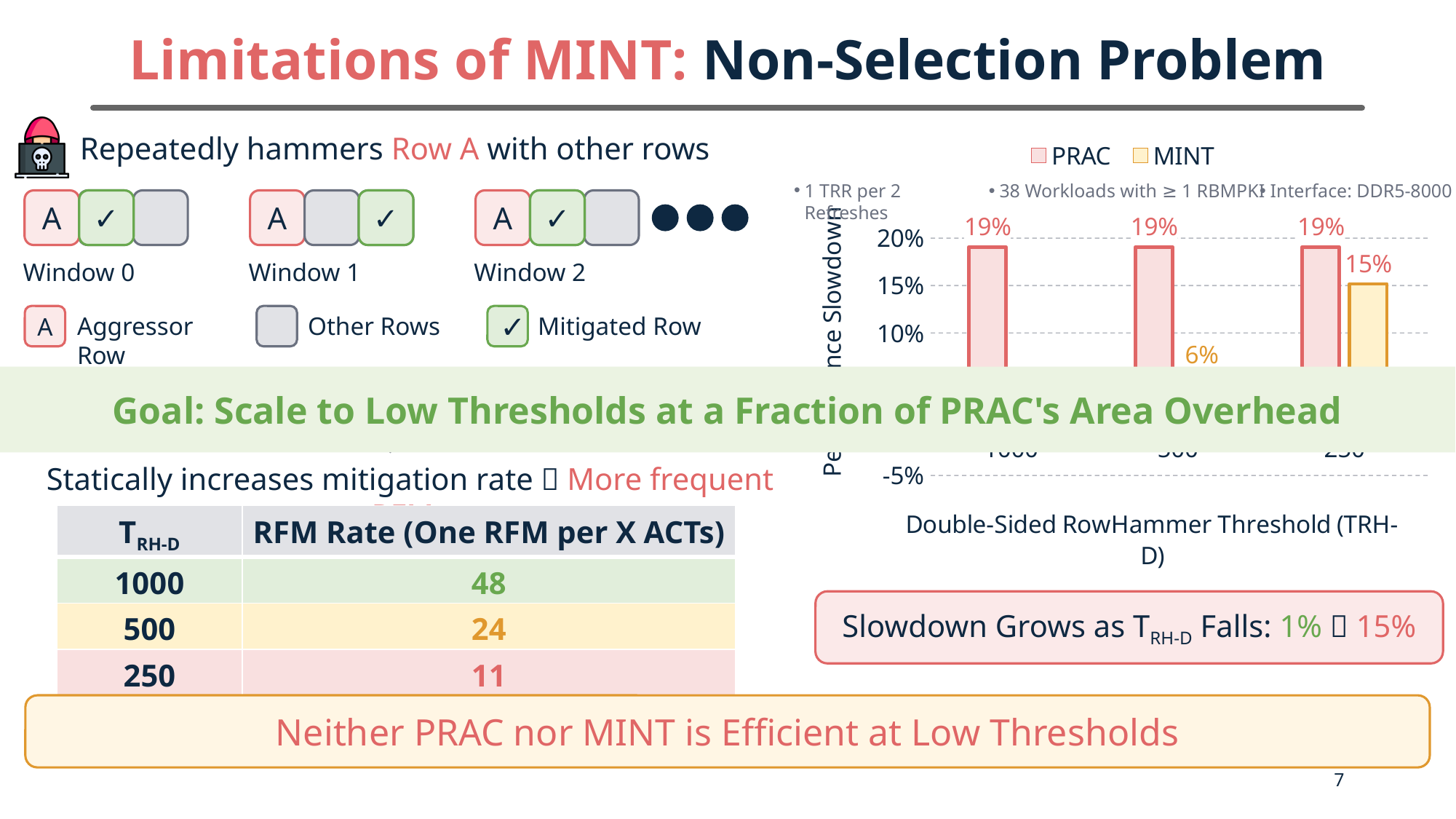
How many series does the chart legend list? 2 What is the performance slowdown for MINT at a threshold of 250? 15% What kind of chart is shown on the right of the slide? Bar chart What is the difference between the PRAC and MINT slowdowns at a threshold of 500? 13% What is the performance slowdown for MINT at a threshold of 500? 6% What is the difference between the PRAC and MINT slowdowns at a threshold of 250? 4% What is the performance slowdown for PRAC at a threshold of 1000? 19% At a threshold of 250, which series has the larger slowdown, PRAC or MINT? PRAC Is the MINT slowdown at a threshold of 250 greater or less than 10%? greater Does the MINT slowdown rise or fall as the threshold goes from 500 to 250? rise What are the two series named in the chart legend? PRAC and MINT What is the performance slowdown for PRAC at a threshold of 250? 19%